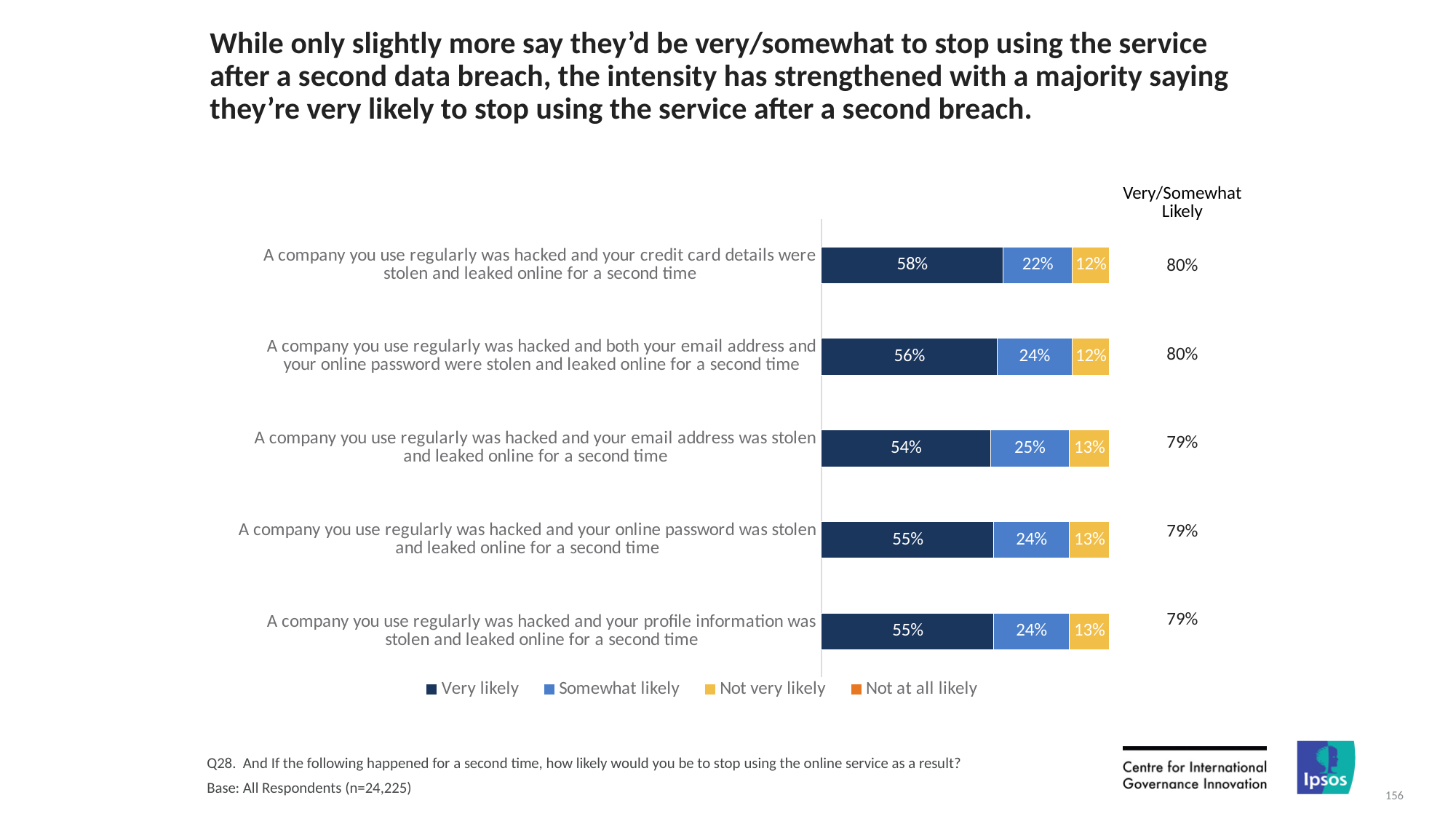
Which scenario has the lowest 'Very likely' percentage? A company you use regularly was hacked and your email address was stolen and leaked online for a second time Which legend entry is shown in dark navy blue? Very likely How many series does the legend list? 4 What percentage of respondents are 'Very likely' to stop using the service if their credit card details were stolen and leaked online for a second time? 58% What kind of chart is shown on the slide? Stacked bar chart How many scenarios (categories) are shown in the chart? 5 What is the difference between the 'Very likely' values for the credit card details scenario and the email address scenario? 4 percentage points What is the 'Not very likely' value for the scenario where the email address was stolen and leaked online for a second time? 13% What is the Very/Somewhat Likely total shown for the scenario where the online password was stolen and leaked online for a second time? 79% Which is larger: the 'Somewhat likely' value for the credit card details scenario or for the email address scenario? The email address scenario (25%) Which scenario has the highest 'Very likely' percentage? A company you use regularly was hacked and your credit card details were stolen and leaked online for a second time What is the 'Somewhat likely' value for the scenario where both email address and online password were stolen and leaked online for a second time? 24%